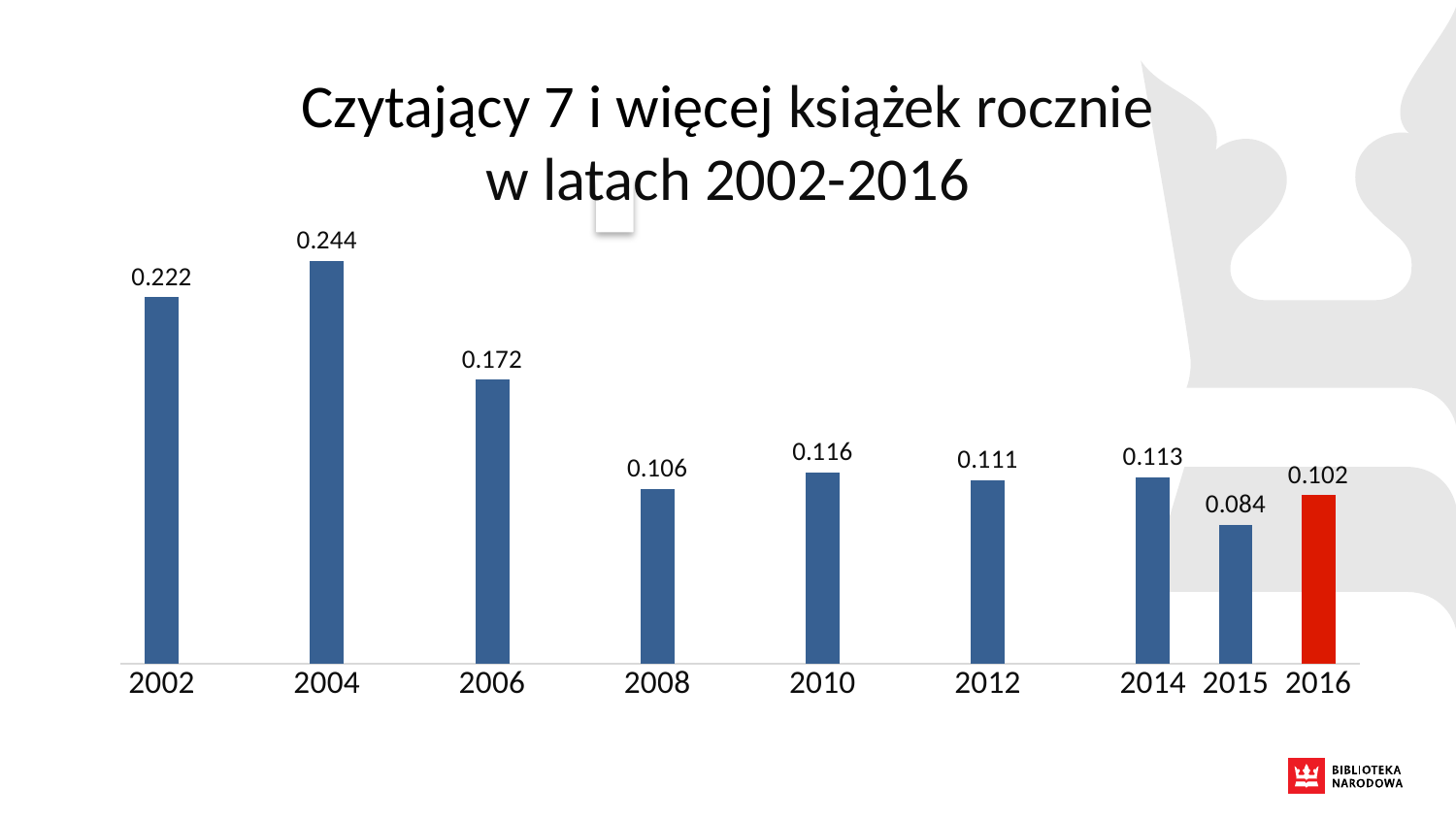
What kind of chart is this? bar chart How many years are shown on the x axis? 9 What is the value for 2016? 0.102 What is the difference between the values for 2002 and 2006? 0.050 Which year has the lowest value? 2015 Which bar is coloured red instead of blue? 2016 What is the value for 2004? 0.244 What is the difference between the values for 2016 and 2015? 0.018 Which is larger, the value for 2010 or the value for 2012? 2010 Do the values generally rise or fall from 2004 to 2008? fall Which year has the highest value? 2004 What is the value for 2015? 0.084